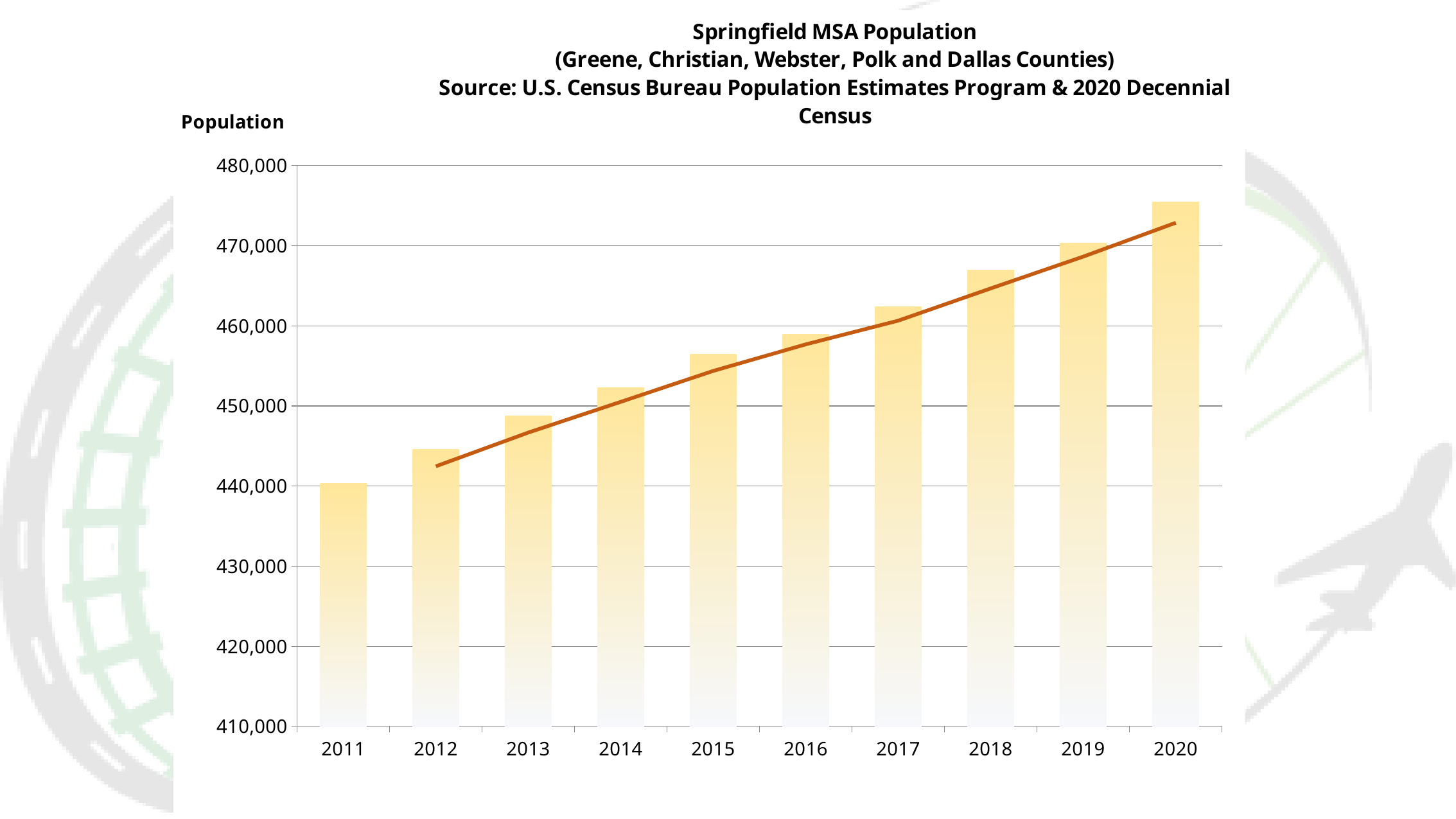
Which year has the highest population bar? 2020 What is the label on the vertical axis of the chart? Population Which counties are listed in the chart title as making up the Springfield MSA? Greene, Christian, Webster, Polk and Dallas Counties Is the population value for 2016 greater or less than 460,000? less Do the population values rise or fall from 2011 to 2020? rise What kind of chart is shown on the slide? bar chart Which year has the larger population bar, 2014 or 2017? 2017 Which year has the lowest population bar? 2011 How many years are shown on the x axis of the chart? 10 Is the population value for 2011 greater or less than 450,000? less Is the population value for 2020 greater or less than 470,000? greater